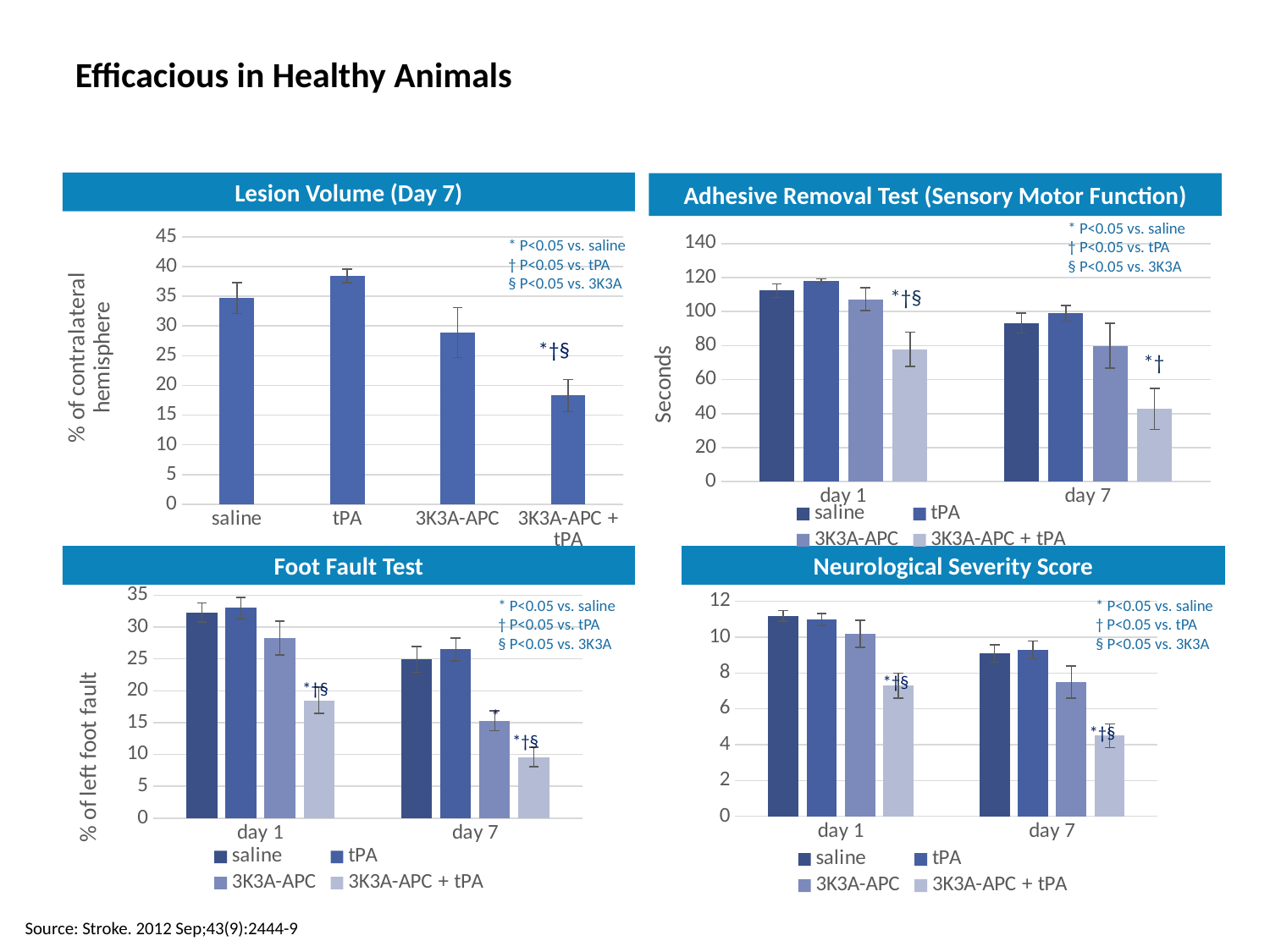
What kind of chart is the Neurological Severity Score chart? bar chart In the Lesion Volume (Day 7) chart, how many categories are shown on the x axis? 4 In the Neurological Severity Score chart, is the value for 3K3A-APC + tPA on day 7 greater or less than 6? less In the Adhesive Removal Test chart, which series has the lowest value on day 7? 3K3A-APC + tPA In the Adhesive Removal Test chart, is the value for 3K3A-APC + tPA on day 7 greater or less than 60? less In the Lesion Volume (Day 7) chart, which category has the lowest value? 3K3A-APC + tPA In the Foot Fault Test chart, does the value for saline rise or fall from day 1 to day 7? fall In the Adhesive Removal Test chart, what is the label on the y axis? Seconds In the Lesion Volume (Day 7) chart, which category has the highest value? tPA In the Lesion Volume (Day 7) chart, is the value for 3K3A-APC + tPA greater or less than 20? less In the Adhesive Removal Test chart, how many series does the legend list? 4